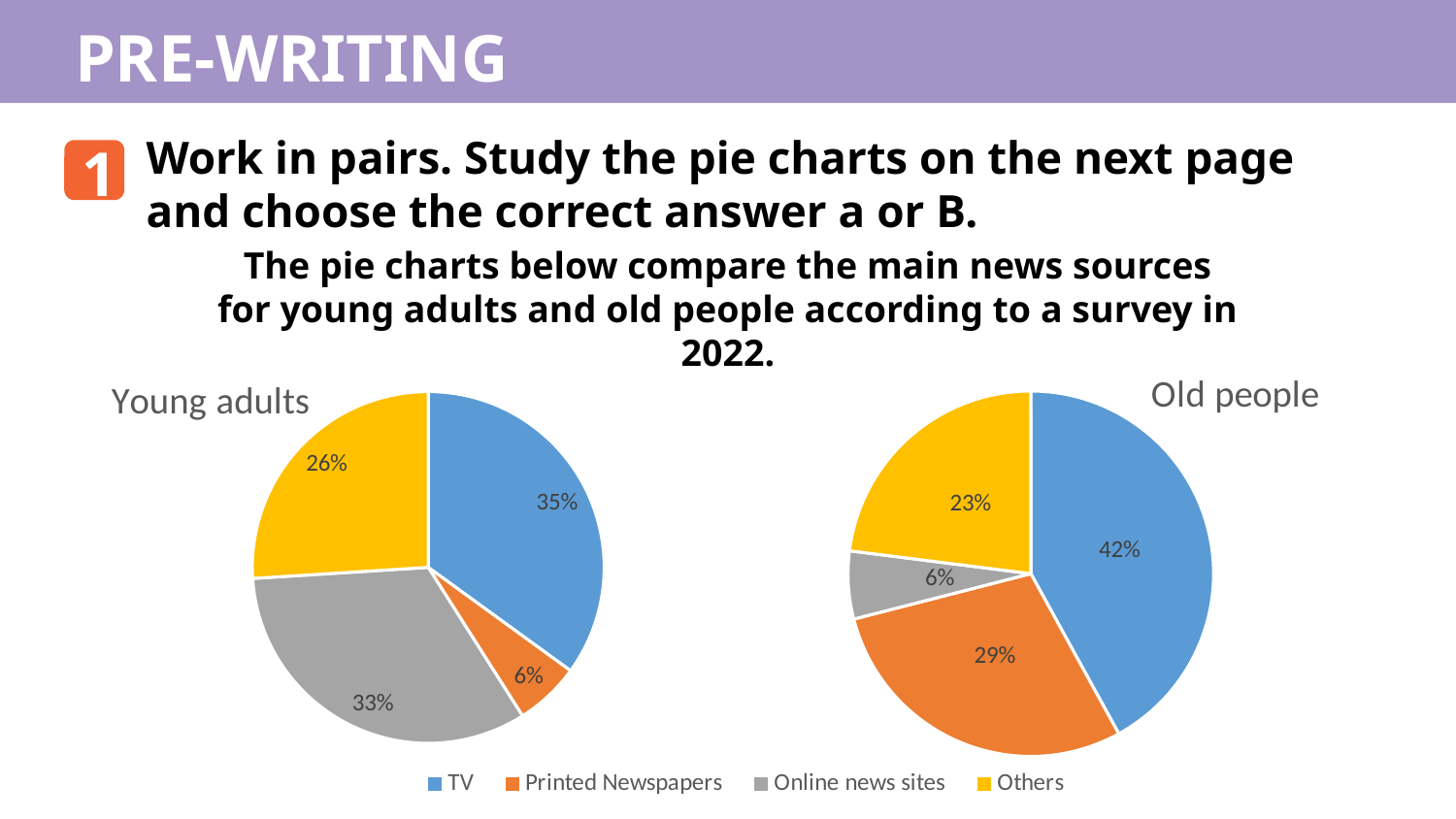
In the Old people pie chart, which news source has the smallest share? Online news sites Which colour represents Online news sites in the legend? Gray In the Old people pie chart, which news source has the largest share? TV Which is larger: the Printed Newspapers share for Young adults or for Old people? Old people In the Young adults pie chart, which news source has the smallest share? Printed Newspapers What type of chart is used to show the news sources for Young adults and Old people? Pie chart How many slices does the Young adults pie chart have? 4 In the Young adults pie chart, what percentage is shown for Online news sites? 33% In the Young adults pie chart, what percentage is shown for TV? 35% In the Old people pie chart, what percentage is shown for Others? 23% What is the difference between the TV share in the Old people pie chart and the TV share in the Young adults pie chart? 7% In the Old people pie chart, what percentage is shown for Printed Newspapers? 29%